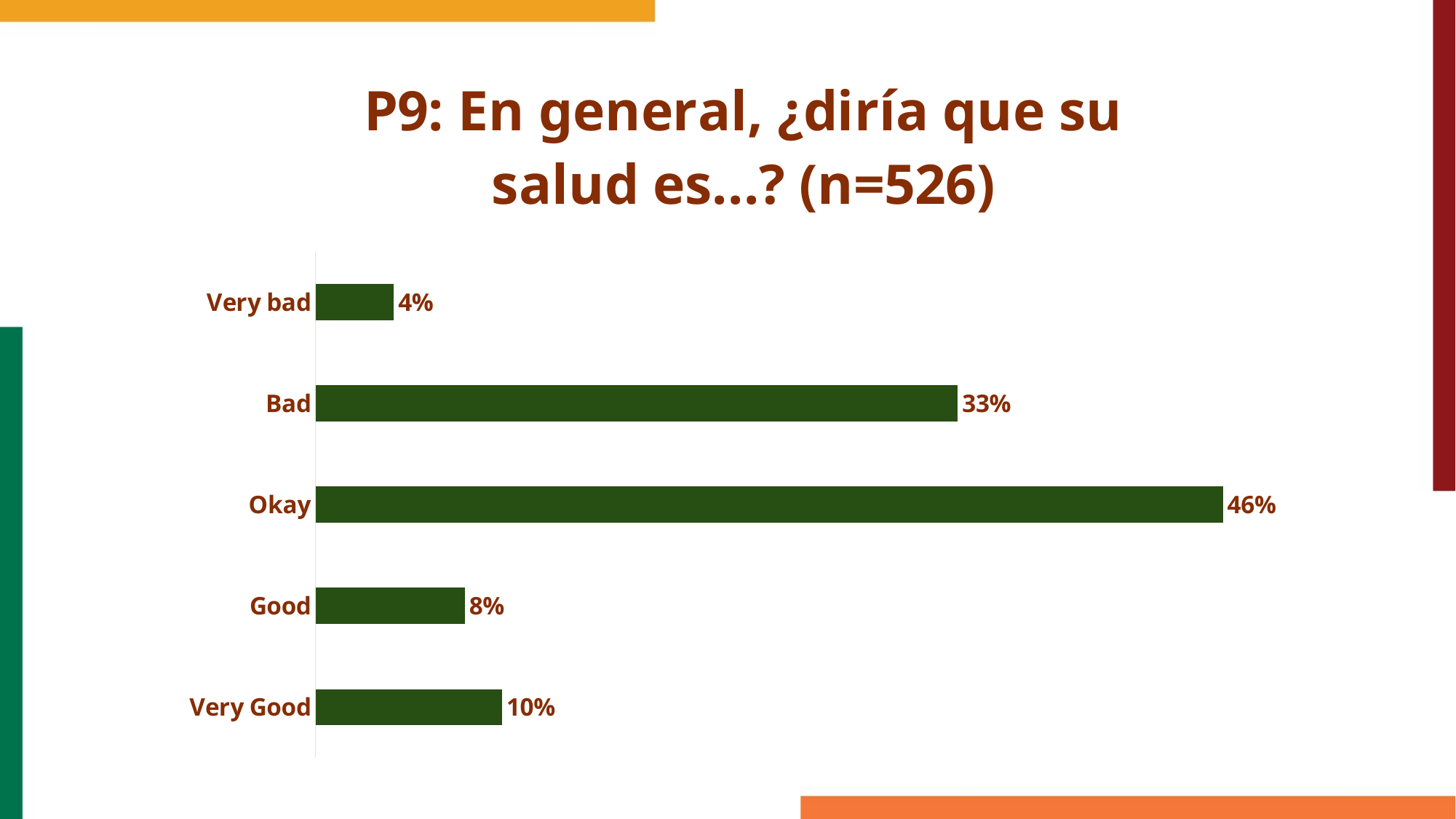
What is the value for Very bad? 4% What is the sample size (n) given in the chart title? 526 What is the value for Very Good? 10% Which category has the lowest value? Very bad Which is larger, the value for Good or the value for Very Good? Very Good What is the difference between the values for Okay and Bad? 13% What is the difference between the values for Very Good and Good? 2% What is the value for Okay? 46% Which category has the highest value? Okay What kind of chart is shown on the slide? Bar chart What is the value for Bad? 33% How many categories are shown in the chart? 5